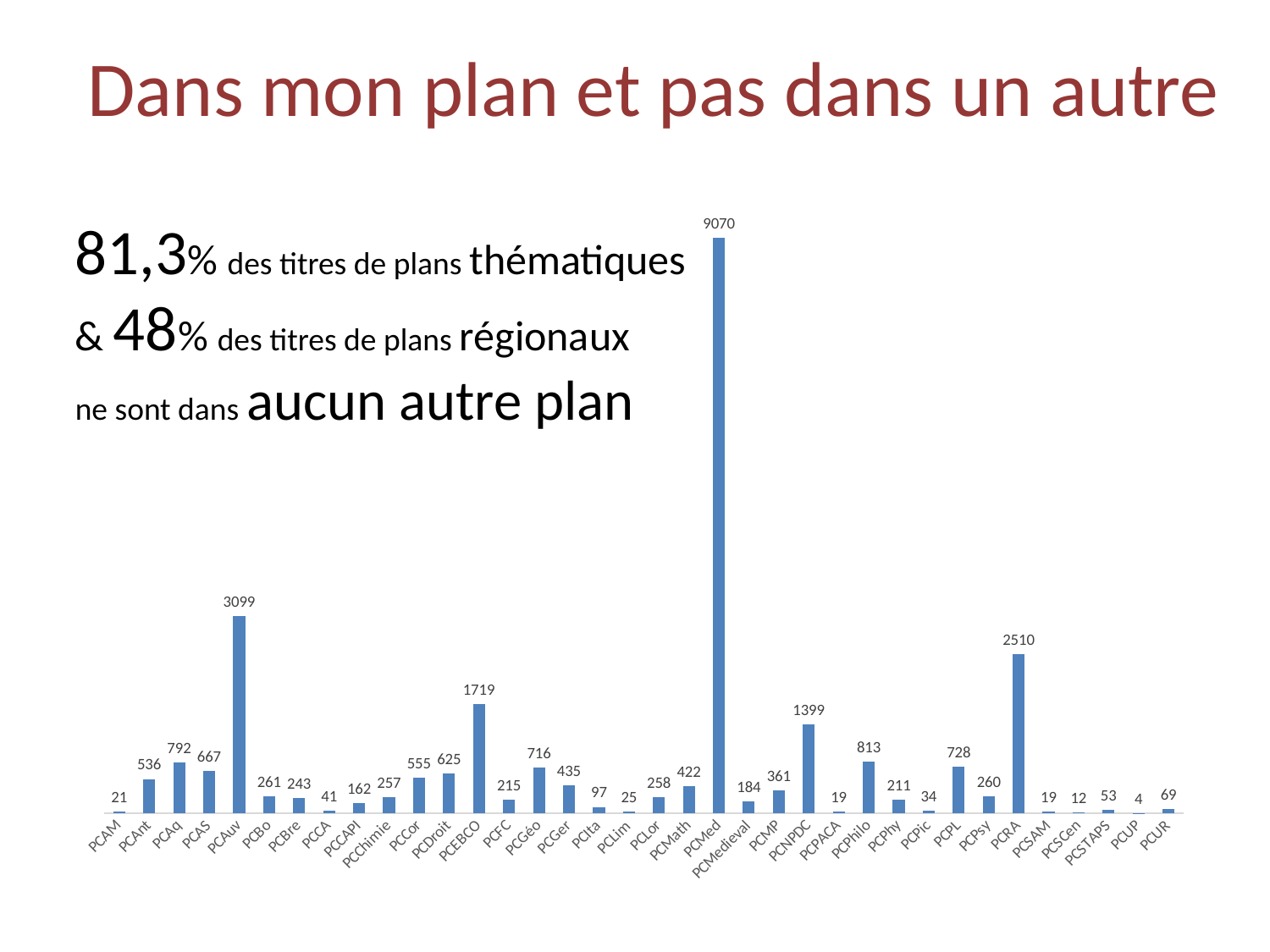
What is the value for PCSTAPS? 53 What is the value for PCMed? 9070 How many categories are shown in the chart? 36 Which is larger, the value for PCAq or the value for PCGéo? PCAq What kind of chart is shown on the slide? bar chart Which category has the lowest value? PCUP What is the value for PCNPDC? 1399 What is the difference between the values for PCEBCO and PCNPDC? 320 What is the difference between the values for PCAuv and PCRA? 589 What is the value for PCAuv? 3099 Which category has the highest value? PCMed Which is larger, the value for PCPhilo or the value for PCPL? PCPhilo